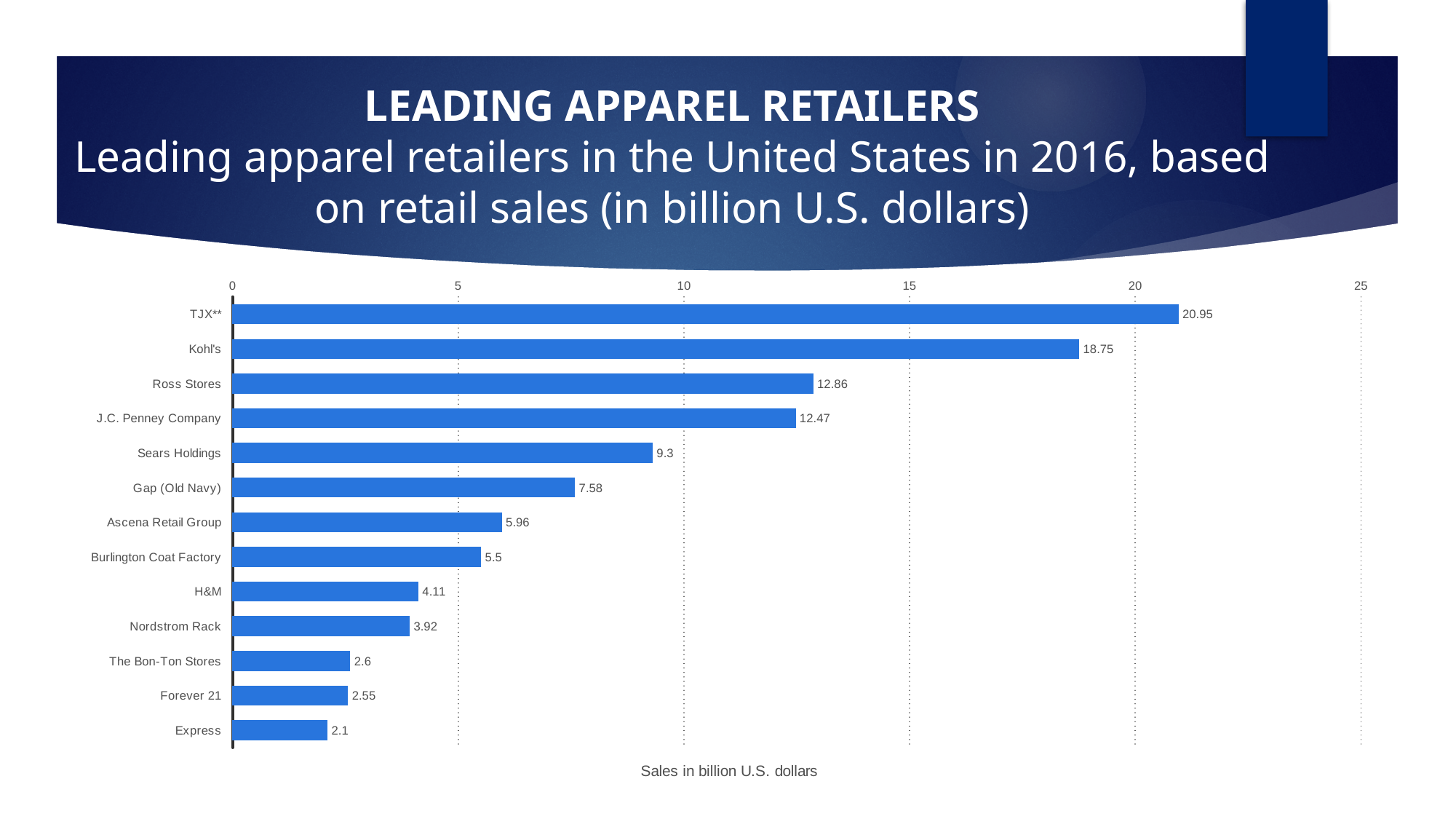
What were the retail sales for Nordstrom Rack in billion U.S. dollars? 3.92 What is the difference in retail sales between TJX** and Kohl's, in billion U.S. dollars? 2.2 Is the value for Burlington Coat Factory greater or less than 5? greater How many retailers are shown in the chart? 13 What is the label on the horizontal axis of the chart? Sales in billion U.S. dollars Which retailer had the lowest retail sales? Express What were the retail sales for Kohl's in billion U.S. dollars? 18.75 What were the retail sales for Sears Holdings in billion U.S. dollars? 9.3 Which retailer had the highest retail sales? TJX** Which had higher retail sales, Gap (Old Navy) or Ascena Retail Group? Gap (Old Navy) What kind of chart is shown on the slide? Bar chart What is the difference in retail sales between Ross Stores and J.C. Penney Company, in billion U.S. dollars? 0.39